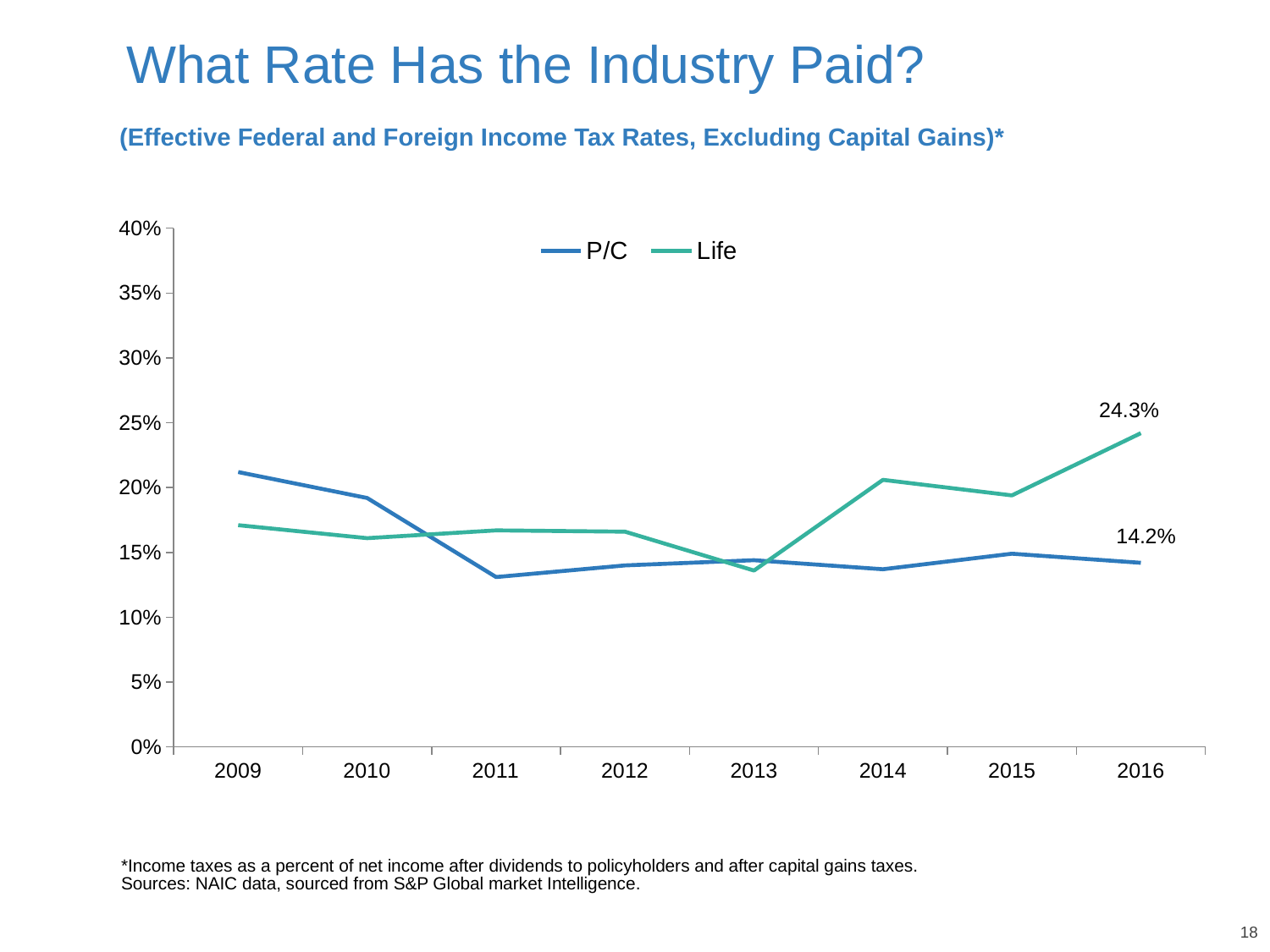
What kind of chart is shown on the slide? line chart In 2009, which series has the higher value, P/C or Life? P/C Is the Life value for 2009 greater or less than 20%? less Is the P/C value for 2011 greater or less than 15%? less What is the P/C value for 2016? 14.2% How many series does the legend list? 2 Does the Life series rise or fall from 2013 to 2016? rise What is the difference between the Life and P/C values in 2016? 10.1% How many years are shown on the x axis? 8 In 2016, which series has the higher value, P/C or Life? Life In which year is the Life series at its highest? 2016 What is the Life value for 2016? 24.3%